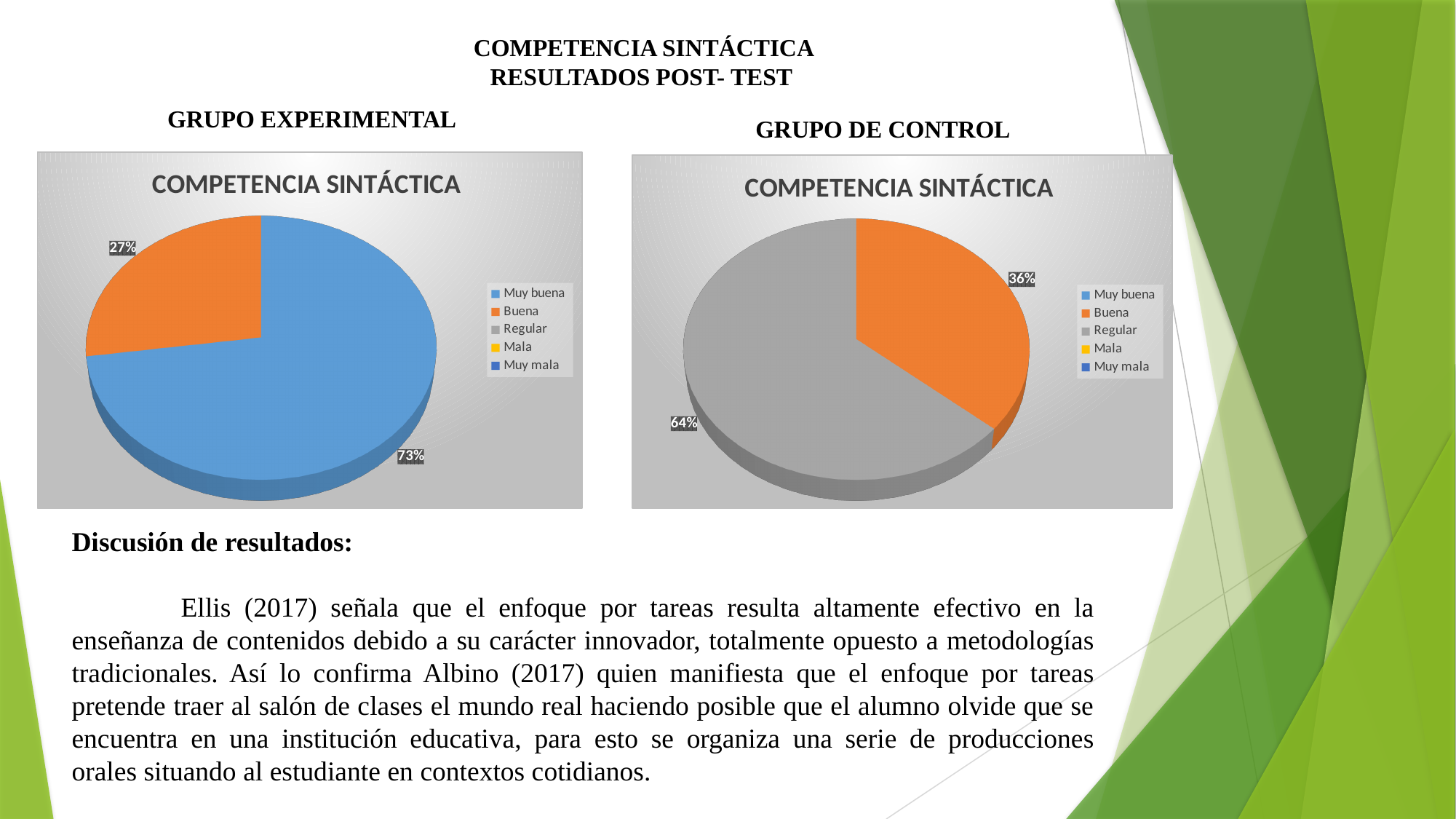
In the GRUPO EXPERIMENTAL pie chart, what share is labelled for the Buena slice? 27% In the GRUPO EXPERIMENTAL pie chart, what share is labelled for the Muy buena slice? 73% In the GRUPO DE CONTROL pie chart, which category has the largest slice? Regular In the GRUPO DE CONTROL pie chart, what share is labelled for the Regular slice? 64% How many categories does the legend of the GRUPO DE CONTROL chart list? 5 In the GRUPO DE CONTROL pie chart, what is the difference in percentage points between the Regular and Buena slices? 28 In the GRUPO DE CONTROL pie chart, which of the two visible slices is smaller? Buena In the GRUPO EXPERIMENTAL pie chart, what is the difference in percentage points between the Muy buena and Buena slices? 46 In the GRUPO DE CONTROL pie chart, what share is labelled for the Buena slice? 36% What type of chart is used for the GRUPO EXPERIMENTAL results? Pie chart In the GRUPO EXPERIMENTAL pie chart, which category has the largest slice? Muy buena Is the Buena slice larger in the GRUPO EXPERIMENTAL chart or in the GRUPO DE CONTROL chart? GRUPO DE CONTROL